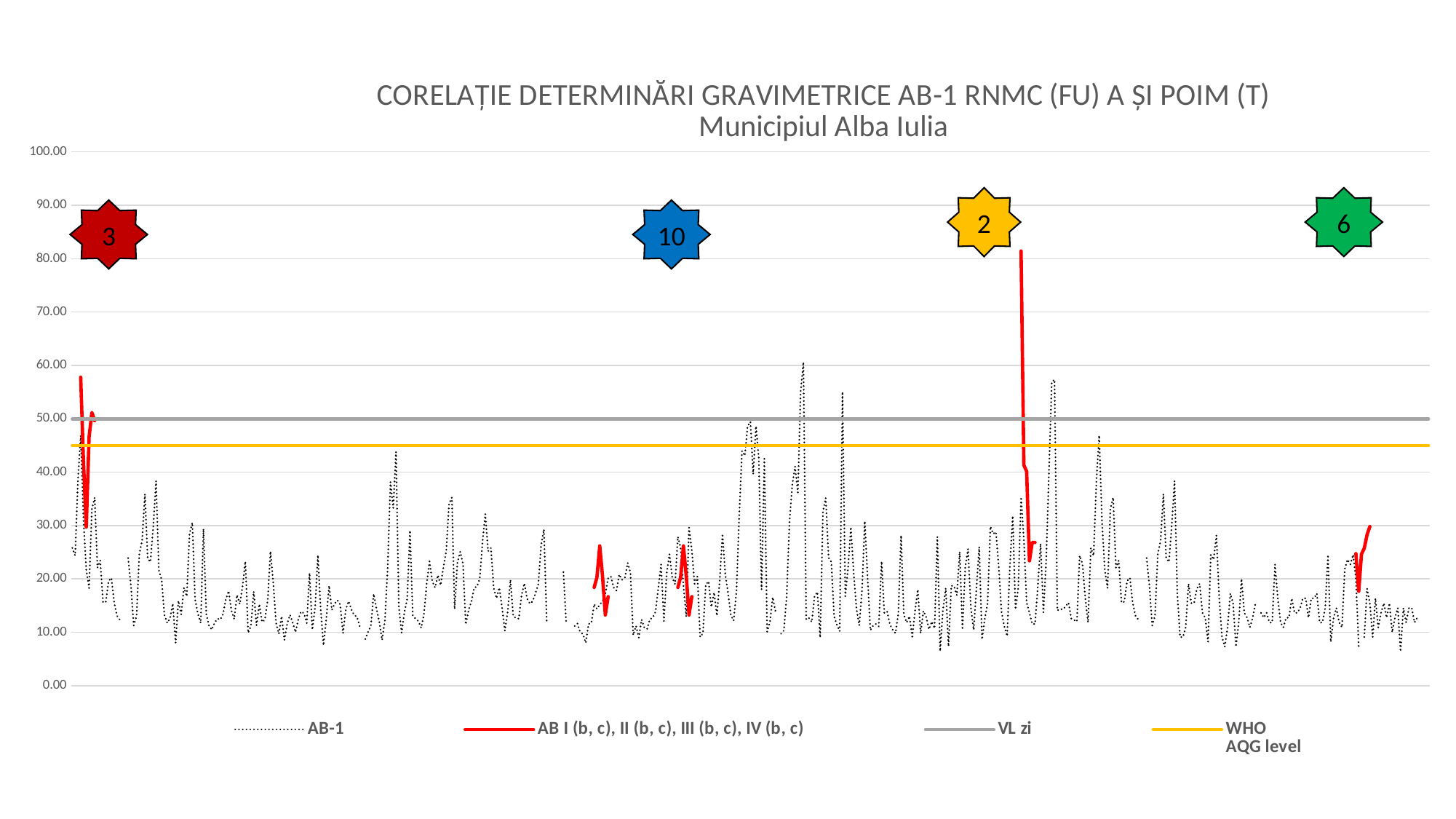
Is the highest peak of the red AB I (b, c), II (b, c), III (b, c), IV (b, c) series greater or less than 70? greater How many series does the legend list? 4 What is the maximum value shown on the y axis? 100.00 Is the highest peak of the AB-1 series greater or less than 50? greater At what value on the y axis is the horizontal VL zi line drawn? 50.00 What kind of chart is shown on the slide? line chart Is the WHO AQG level line greater or less than 50? less Which horizontal reference line is higher, VL zi or WHO AQG level? VL zi What is the title of the chart? CORELAȚIE DETERMINĂRI GRAVIMETRICE AB-1 RNMC (FU) A ȘI POIM (T) Municipiul Alba Iulia Which series is drawn as a dotted black line? AB-1